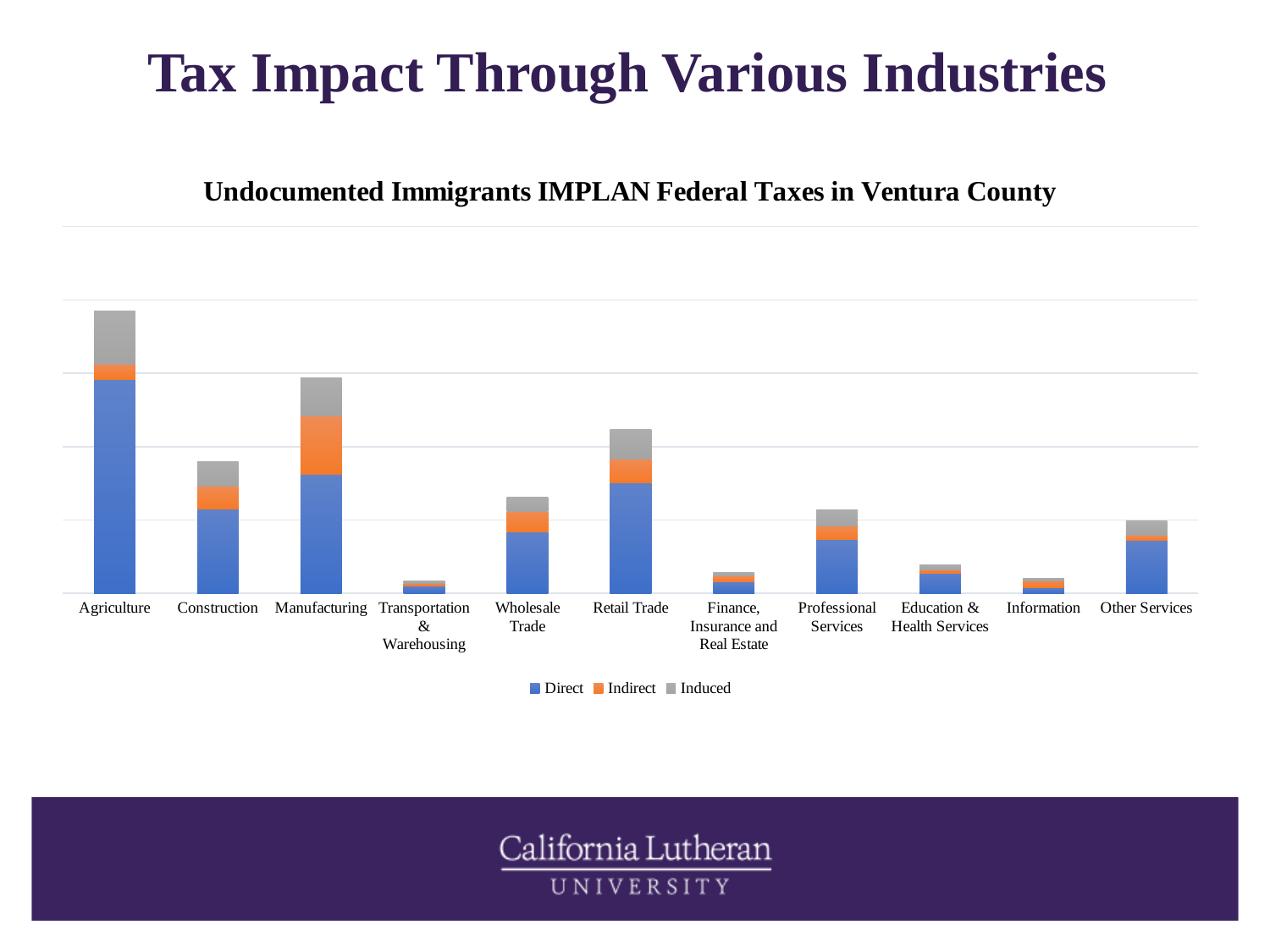
What is the title of the chart? Undocumented Immigrants IMPLAN Federal Taxes in Ventura County Which has a larger total bar, Manufacturing or Retail Trade? Manufacturing Which series is shown in orange in the chart's legend? Indirect Which industry has the largest Direct segment in the chart? Agriculture Which has a larger total bar, Wholesale Trade or Education & Health Services? Wholesale Trade Which industry has the highest total federal tax impact in the chart? Agriculture How many series does the chart's legend list? 3 Which has a larger total bar, Retail Trade or Construction? Retail Trade What kind of chart is shown on the slide? Stacked bar chart Which industry has the largest Indirect segment in the chart? Manufacturing How many industries are shown on the x axis of the chart? 11